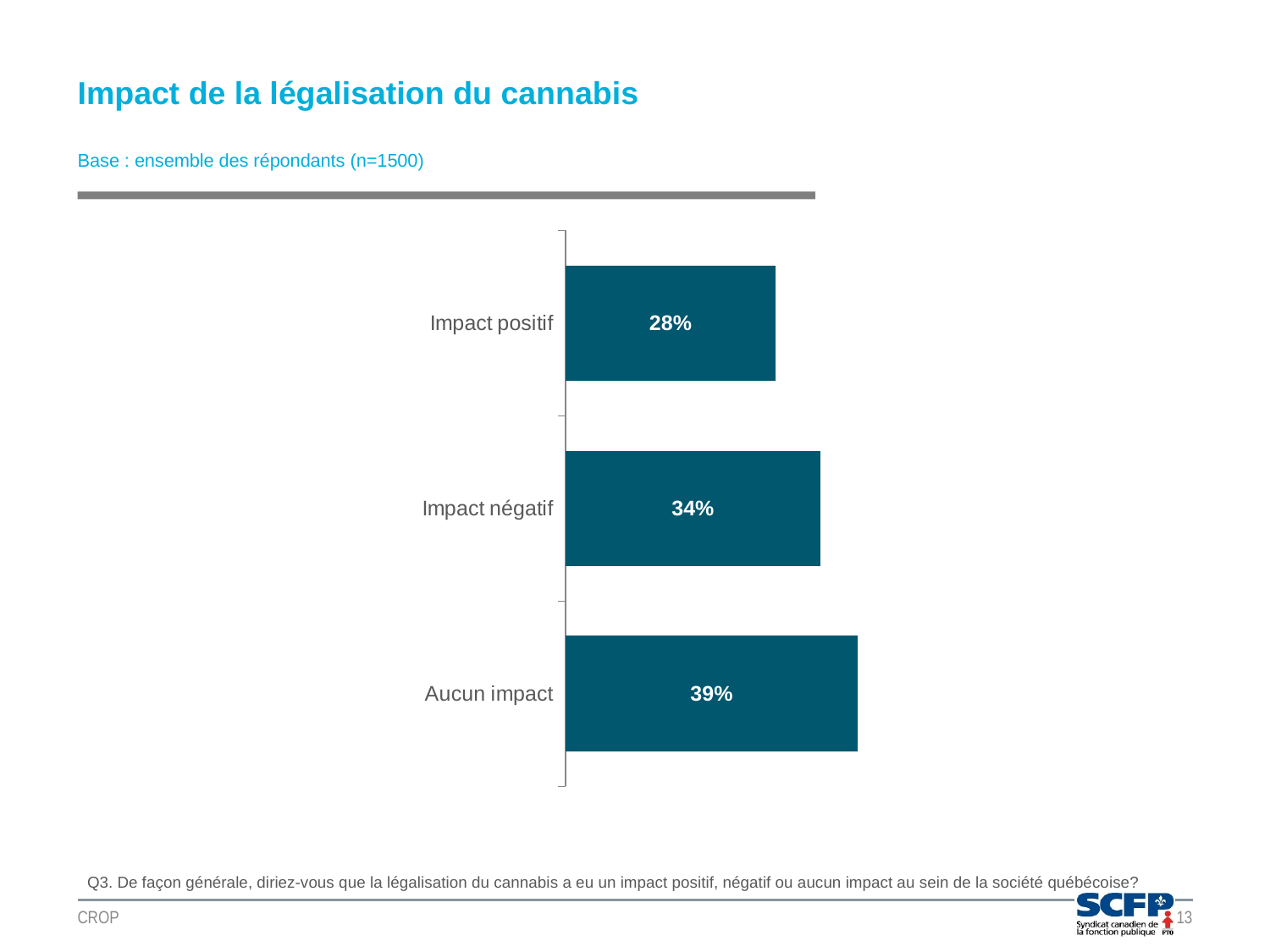
What is the base (number of respondents) stated on the slide? n=1500 What is the value for Impact négatif? 34% What is the value for Impact positif? 28% What kind of chart is shown on the slide? Bar chart Which category has the highest value? Aucun impact How many categories are shown in the chart? 3 Which is larger, the value for Impact négatif or the value for Impact positif? Impact négatif What is the difference between the values for Impact négatif and Impact positif? 6% Which category has the lowest value? Impact positif What is the value for Aucun impact? 39% What is the difference between the values for Aucun impact and Impact positif? 11% What is the title of the slide? Impact de la légalisation du cannabis